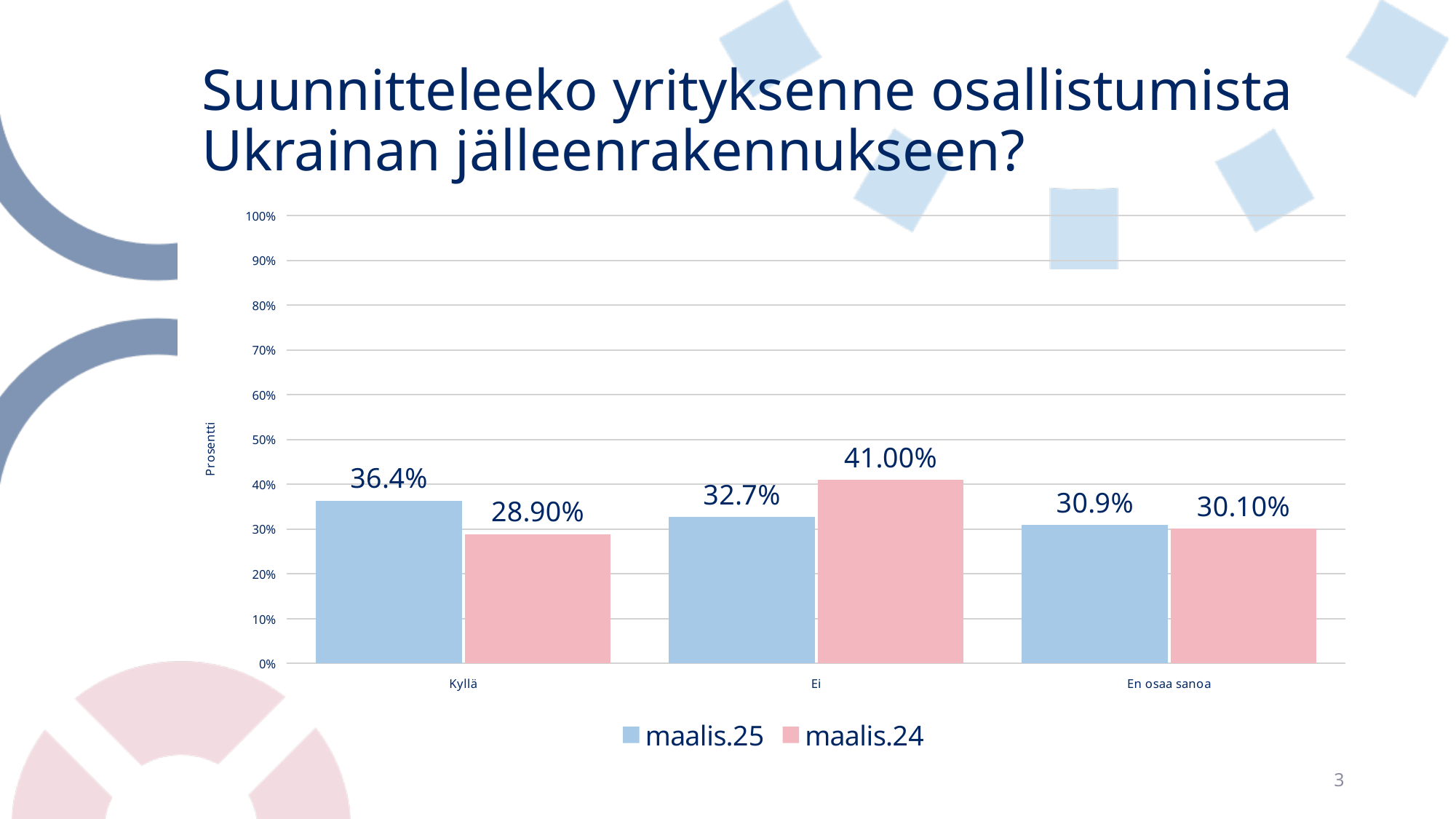
How many series does the legend list? 2 What is the difference between the maalis.24 and maalis.25 values for Ei? 8.3 percentage points For Ei, which series has the larger value, maalis.25 or maalis.24? maalis.24 How many categories are shown on the x axis? 3 What is the value for En osaa sanoa in the maalis.25 series? 30.9% What kind of chart is shown on the slide? Bar chart What is the value for Ei in the maalis.24 series? 41.00% Which category has the lowest value in the maalis.25 series? En osaa sanoa Which category has the highest value in the maalis.24 series? Ei What is the value for Kyllä in the maalis.25 series? 36.4% What is the difference between the maalis.25 and maalis.24 values for Kyllä? 7.5 percentage points What is the value for Kyllä in the maalis.24 series? 28.90%